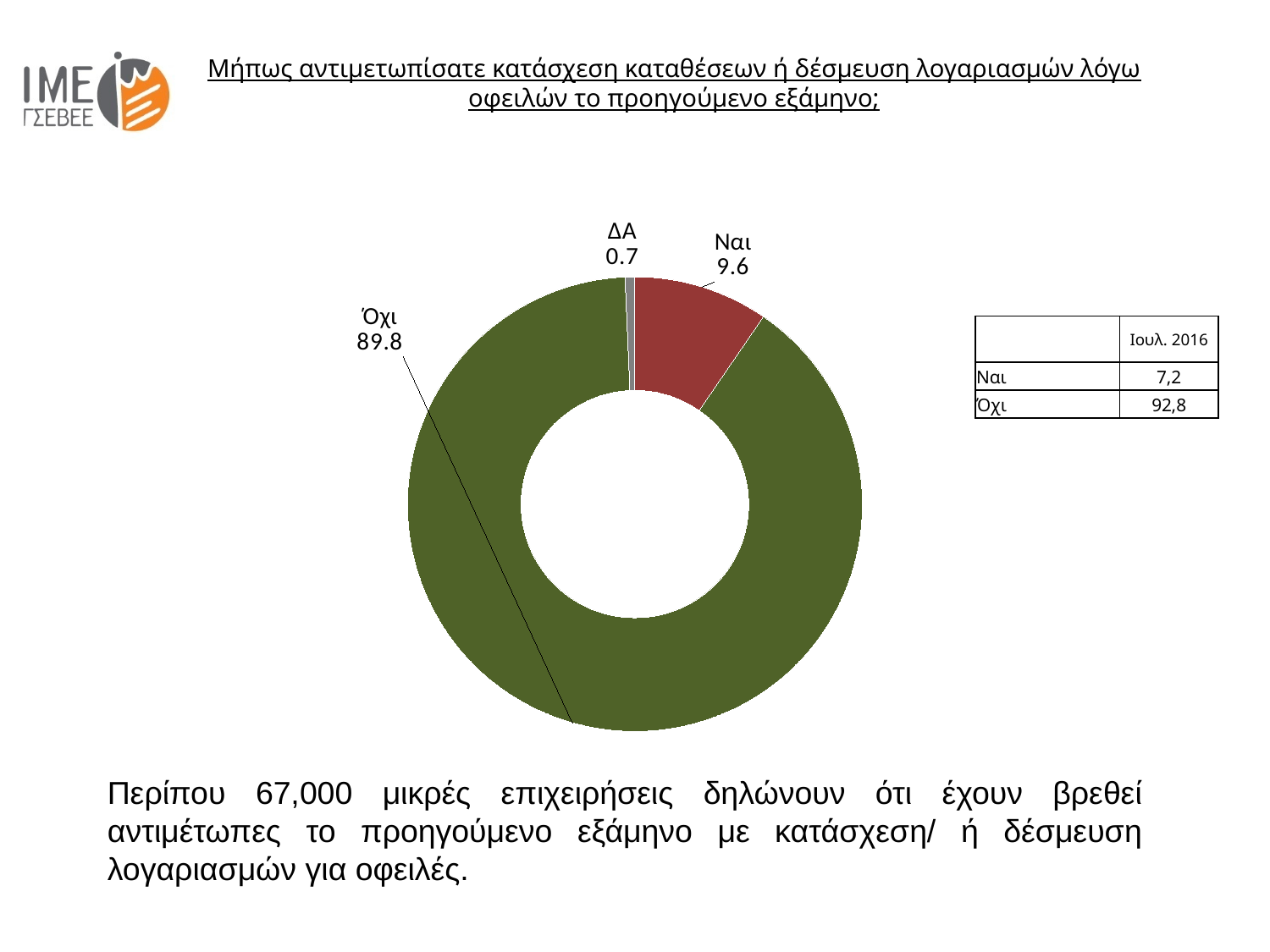
What is the value shown for the ΔΑ slice of the doughnut chart? 0.7 Which is larger in the doughnut chart, the value for Ναι or the value for ΔΑ? Ναι What kind of chart is shown on the slide? Doughnut (pie) chart What is the difference between the values for Όχι and Ναι in the doughnut chart? 80.2 What is the difference between the values for Ναι and ΔΑ in the doughnut chart? 8.9 What is the value shown for the Ναι slice of the doughnut chart? 9.6 What is the value shown for the Όχι slice of the doughnut chart? 89.8 Which category has the smallest slice in the doughnut chart? ΔΑ What colour is the Ναι slice in the doughnut chart? Red What colour is the Όχι slice in the doughnut chart? Green Which category has the largest slice in the doughnut chart? Όχι How many categories are shown in the doughnut chart? 3